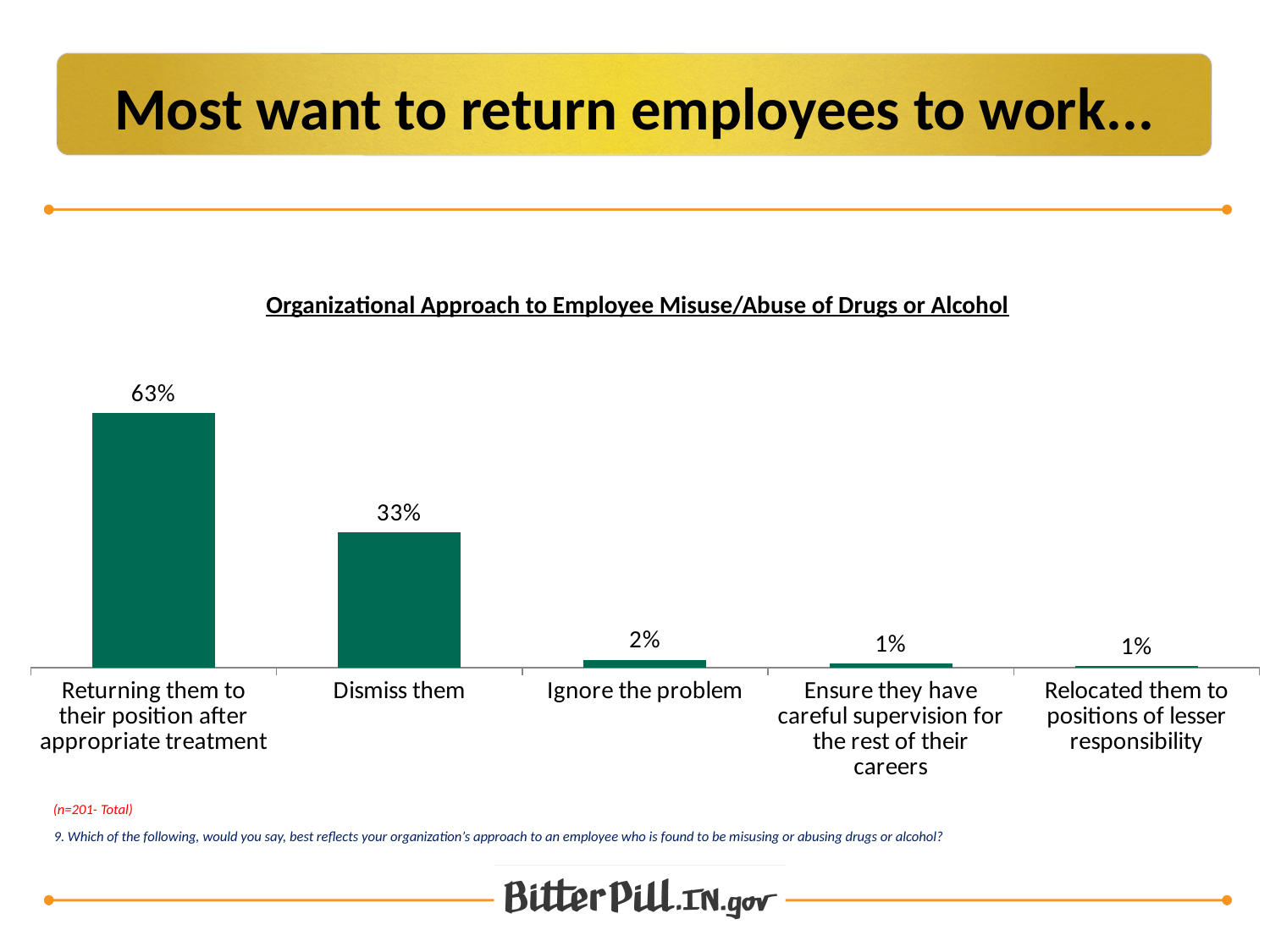
What is the value for "Ensure they have careful supervision for the rest of their careers"? 1% What is the value for "Dismiss them"? 33% How many organizational approaches are shown in the chart? 5 What percentage of organizations said they would return employees to their position after appropriate treatment? 63% What percentage of organizations said they would ignore the problem? 2% What is the title of the chart? Organizational Approach to Employee Misuse/Abuse of Drugs or Alcohol What is the sample size (n) noted below the chart? 201 Which organizational approach has the highest percentage? Returning them to their position after appropriate treatment What is the difference in percentage points between "Returning them to their position after appropriate treatment" and "Dismiss them"? 30 Which is larger, the value for "Dismiss them" or the value for "Ignore the problem"? Dismiss them Do the values rise or fall moving from left to right across the categories? Fall What type of chart is shown on the slide? Bar chart